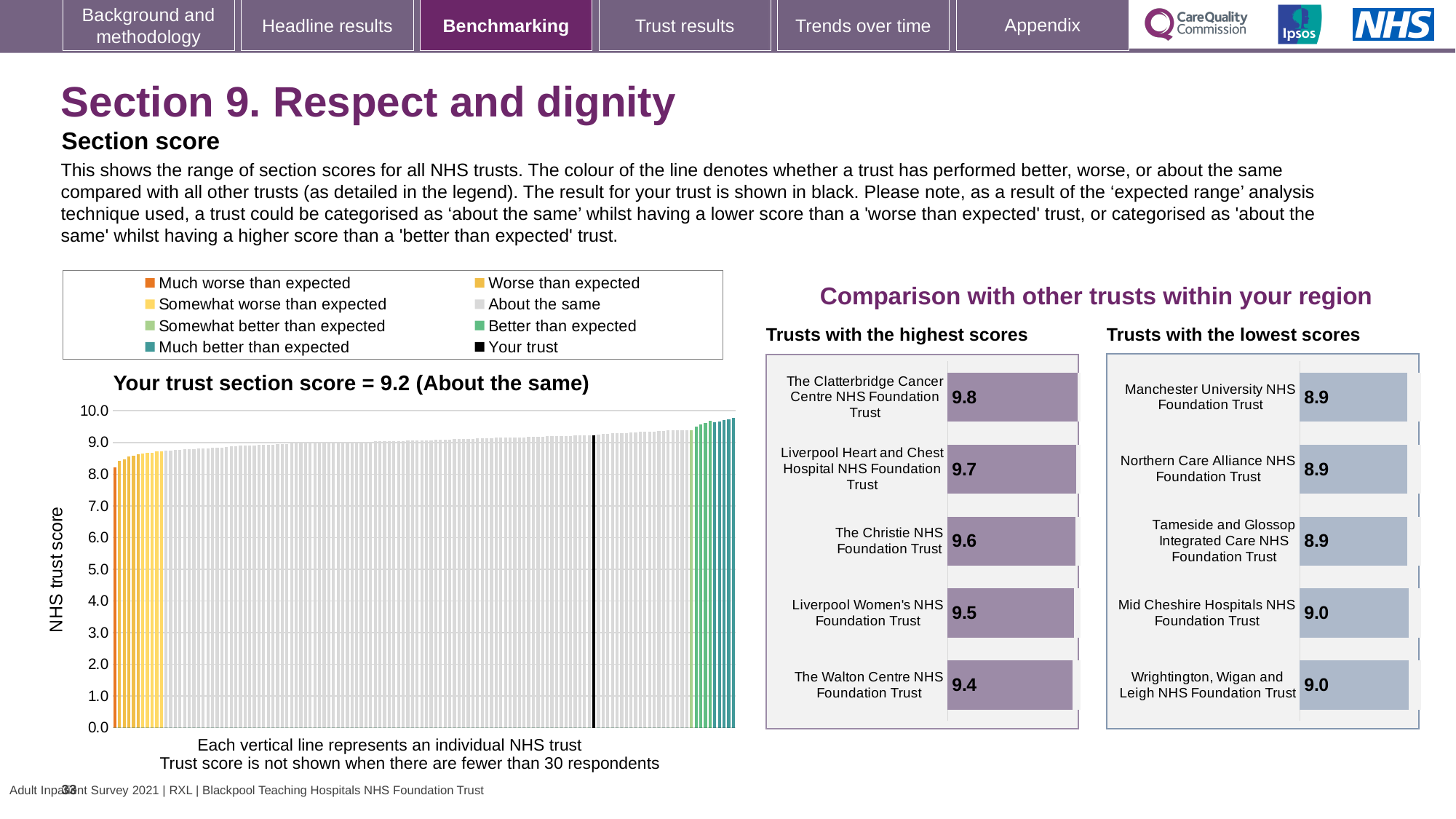
On the 'Trusts with the highest scores' chart, what is the score for The Christie NHS Foundation Trust? 9.6 On the 'Your trust section score' chart, do the trust scores rise or fall from left to right? Rise On the 'Your trust section score' chart, is the value for the lowest-scoring trust greater or less than 8.0? greater On the 'Your trust section score' chart, how many entries does the legend list? 8 On the 'Trusts with the lowest scores' chart, which has the larger score: Manchester University NHS Foundation Trust or Wrightington, Wigan and Leigh NHS Foundation Trust? Wrightington, Wigan and Leigh NHS Foundation Trust What kind of chart is the 'Your trust section score' chart? Bar chart On the 'Trusts with the highest scores' chart, what is the difference between the scores of The Clatterbridge Cancer Centre NHS Foundation Trust and The Walton Centre NHS Foundation Trust? 0.4 On the 'Trusts with the lowest scores' chart, how many trusts are shown? 5 On the 'Your trust section score' chart, what is the section score for your trust? 9.2 On the 'Trusts with the lowest scores' chart, what is the score for Mid Cheshire Hospitals NHS Foundation Trust? 9.0 On the 'Trusts with the highest scores' chart, which trust has the highest score? The Clatterbridge Cancer Centre NHS Foundation Trust On the 'Your trust section score' chart, what is the label of the vertical axis? NHS trust score